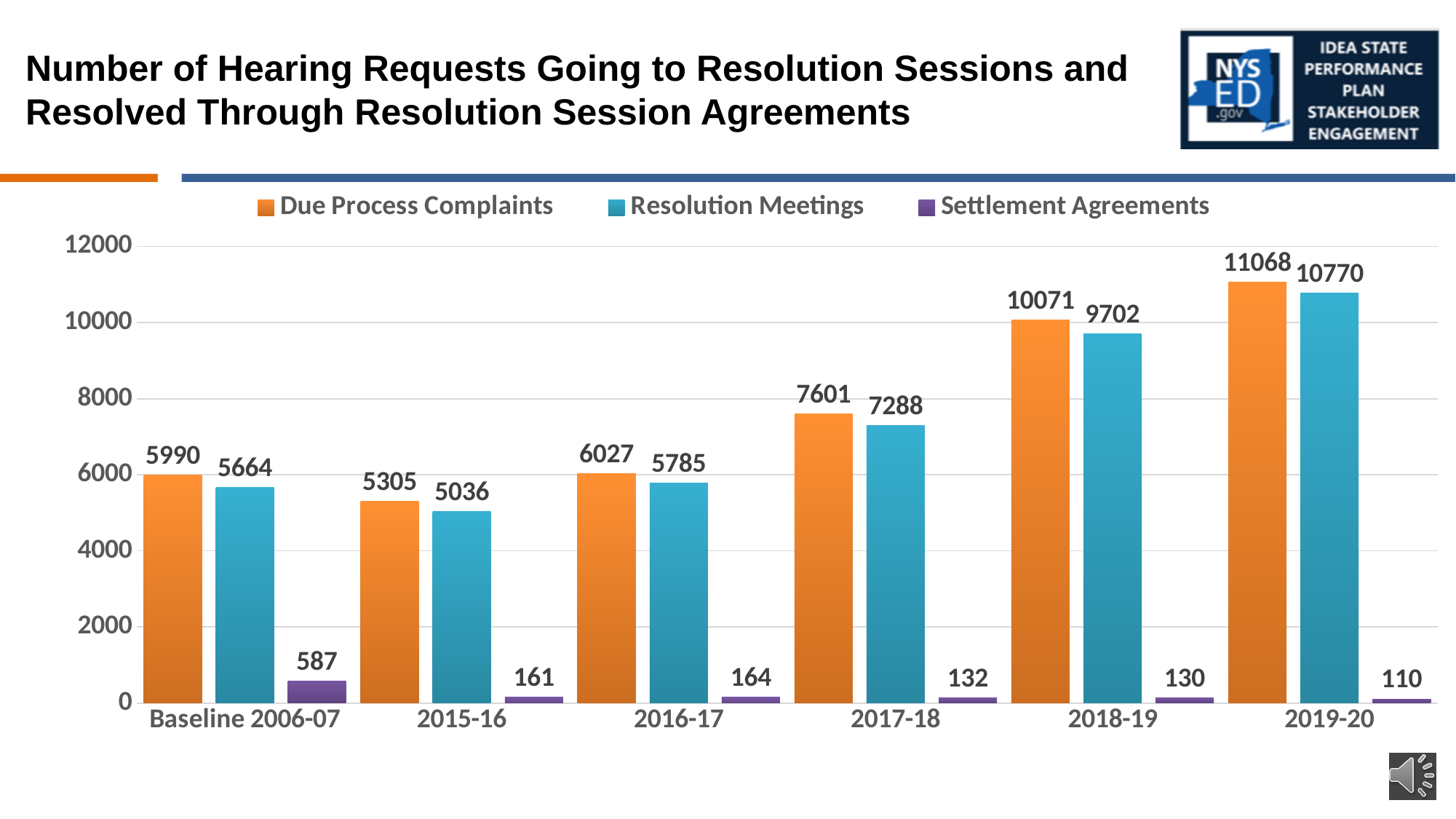
What kind of chart is shown on the slide? bar chart Which year has the lowest value for Resolution Meetings? 2015-16 Is the value for Resolution Meetings in 2019-20 greater or less than 10000? greater Do the Settlement Agreements values rise or fall from 2016-17 to 2019-20? fall What is the value for Resolution Meetings in 2017-18? 7288 How many series does the legend list? 3 How many year categories are shown on the x axis? 6 What is the difference between Due Process Complaints and Resolution Meetings in 2018-19? 369 Which year has the highest value for Due Process Complaints? 2019-20 Which is larger in 2016-17: Due Process Complaints or Resolution Meetings? Due Process Complaints What is the value for Due Process Complaints in 2019-20? 11068 What is the value for Settlement Agreements in Baseline 2006-07? 587